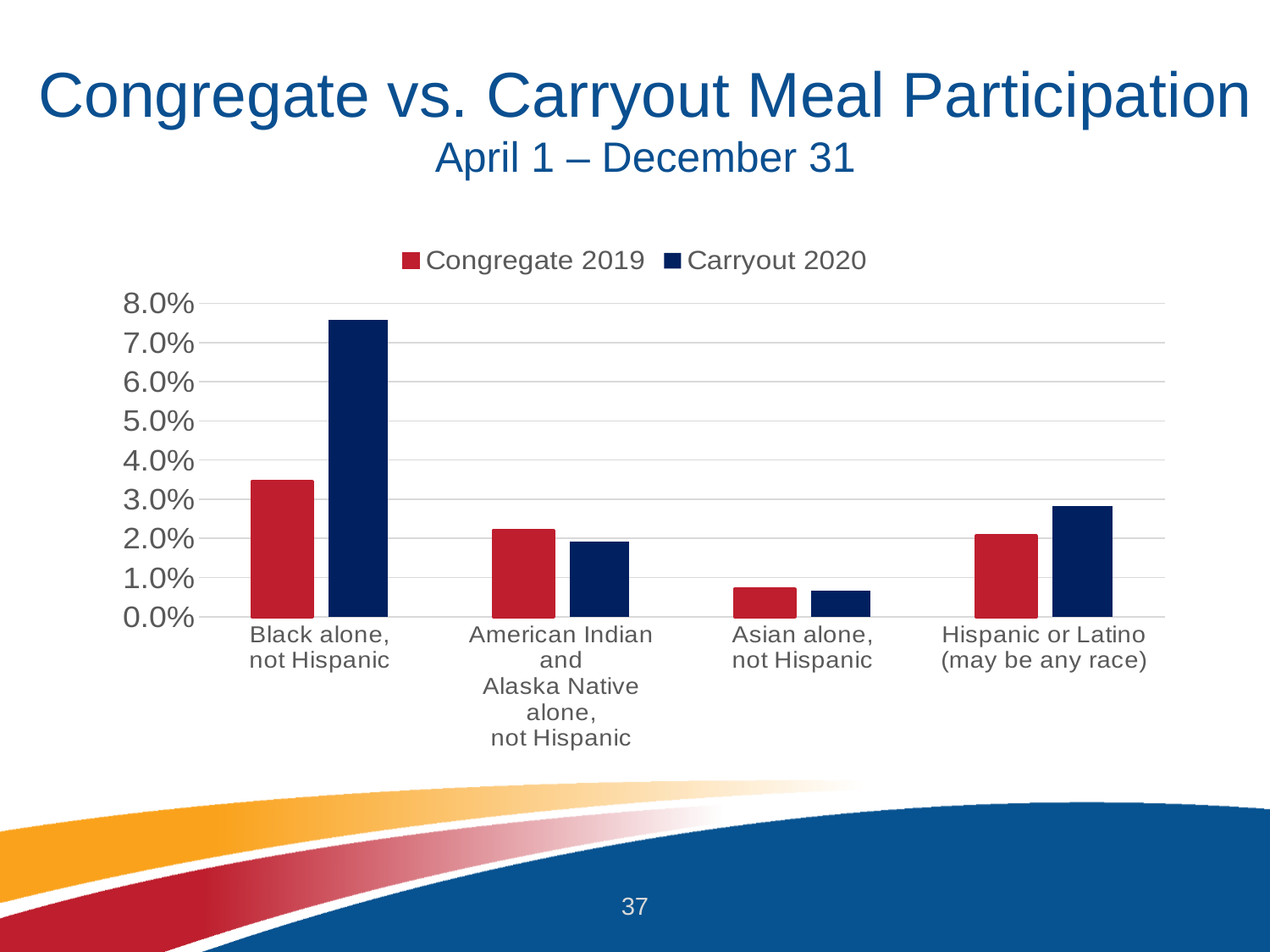
Is the Congregate 2019 value for Asian alone, not Hispanic greater or less than 1.0%? less Which category has the lowest Congregate 2019 value? Asian alone, not Hispanic Which category has the highest Carryout 2020 value? Black alone, not Hispanic Is the Congregate 2019 value for Black alone, not Hispanic greater or less than 3.0%? greater Is the Carryout 2020 value for Black alone, not Hispanic greater or less than 7.0%? greater What kind of chart is shown on the slide? bar chart What are the two series named in the legend? Congregate 2019 and Carryout 2020 How many series does the legend list? 2 For American Indian and Alaska Native alone, not Hispanic, which is larger: Congregate 2019 or Carryout 2020? Congregate 2019 For Hispanic or Latino (may be any race), which is larger: Congregate 2019 or Carryout 2020? Carryout 2020 How many categories are shown on the x axis? 4